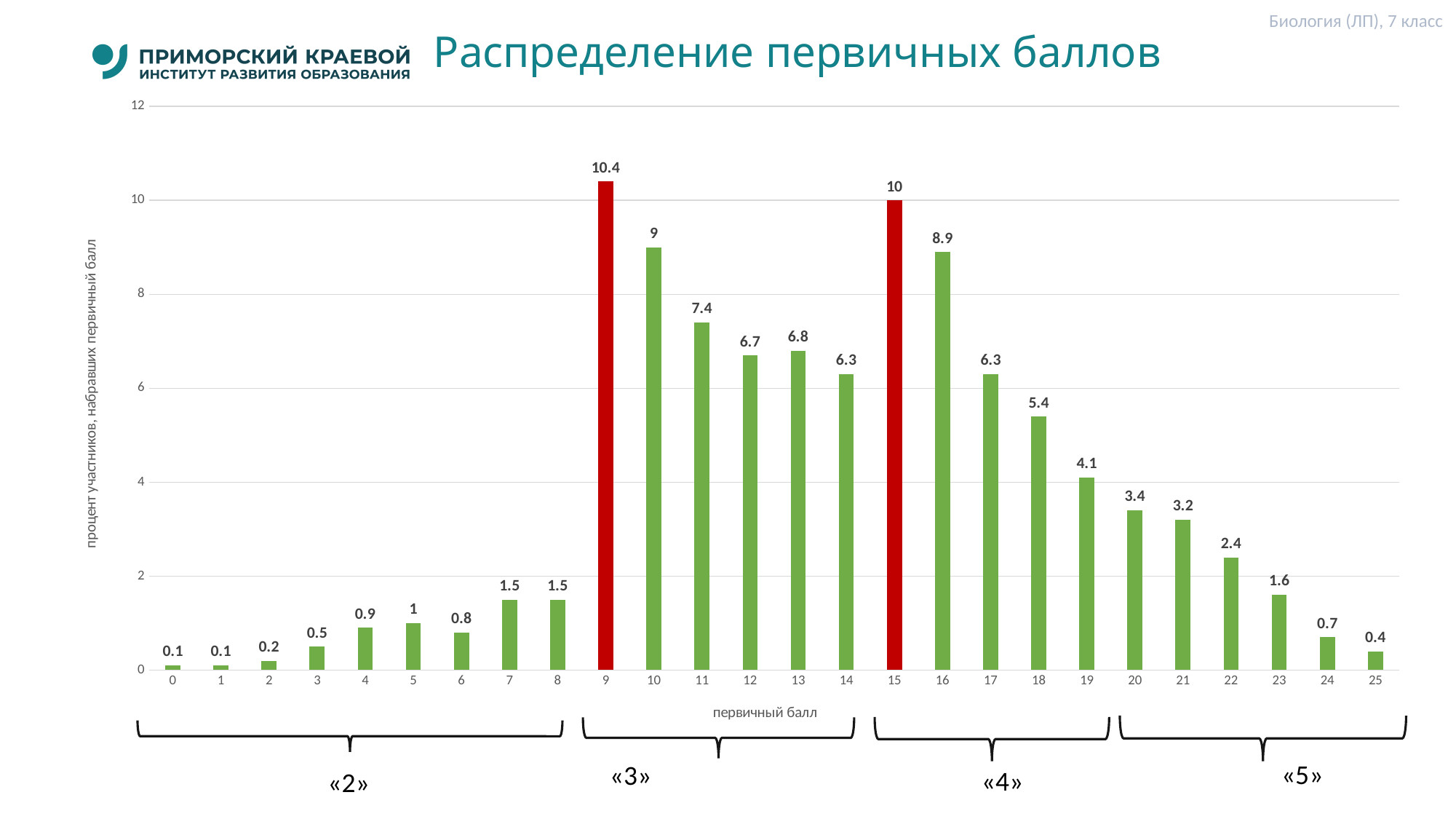
Is the value for первичный балл 19 greater or less than 6? less What is the value for первичный балл 22? 2.4 Which первичный балл has the highest value? 9 What is the value for первичный балл 9? 10.4 What is the difference between the values for первичный балл 9 and первичный балл 15? 0.4 Which is larger, the value for первичный балл 11 or первичный балл 16? 16 How many первичный балл categories are shown on the x axis? 26 What is the title of the chart? Распределение первичных баллов Do the values rise or fall from первичный балл 15 to первичный балл 25? fall What is the value for первичный балл 18? 5.4 What is the lowest value shown on the chart? 0.1 What kind of chart is shown on the slide? bar chart